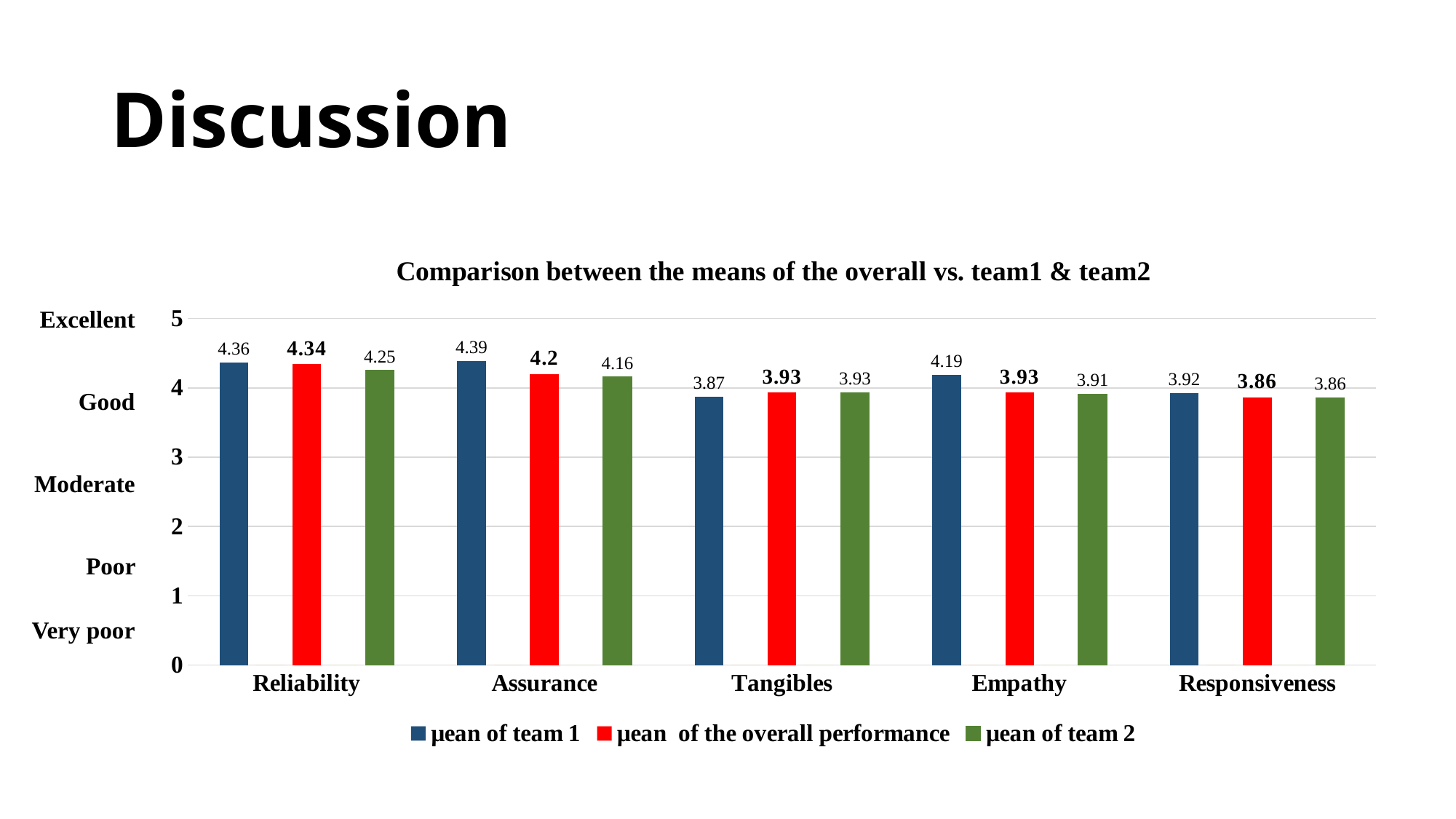
What is the mean of the overall performance for Assurance? 4.2 How many categories are shown on the x axis? 5 Which is larger for Tangibles: the mean of team 1 or the mean of the overall performance? mean of the overall performance What kind of chart is shown on the slide? bar chart Which category has the lowest mean of team 2? Responsiveness What is the title of the chart? Comparison between the means of the overall vs. team1 & team2 How many series does the legend list? 3 What is the mean of the overall performance for Responsiveness? 3.86 What is the mean of team 1 for Reliability? 4.36 Which category has the highest mean of team 1? Assurance What is the mean of team 2 for Empathy? 3.91 What is the difference between the mean of team 1 and the mean of team 2 for Assurance? 0.23